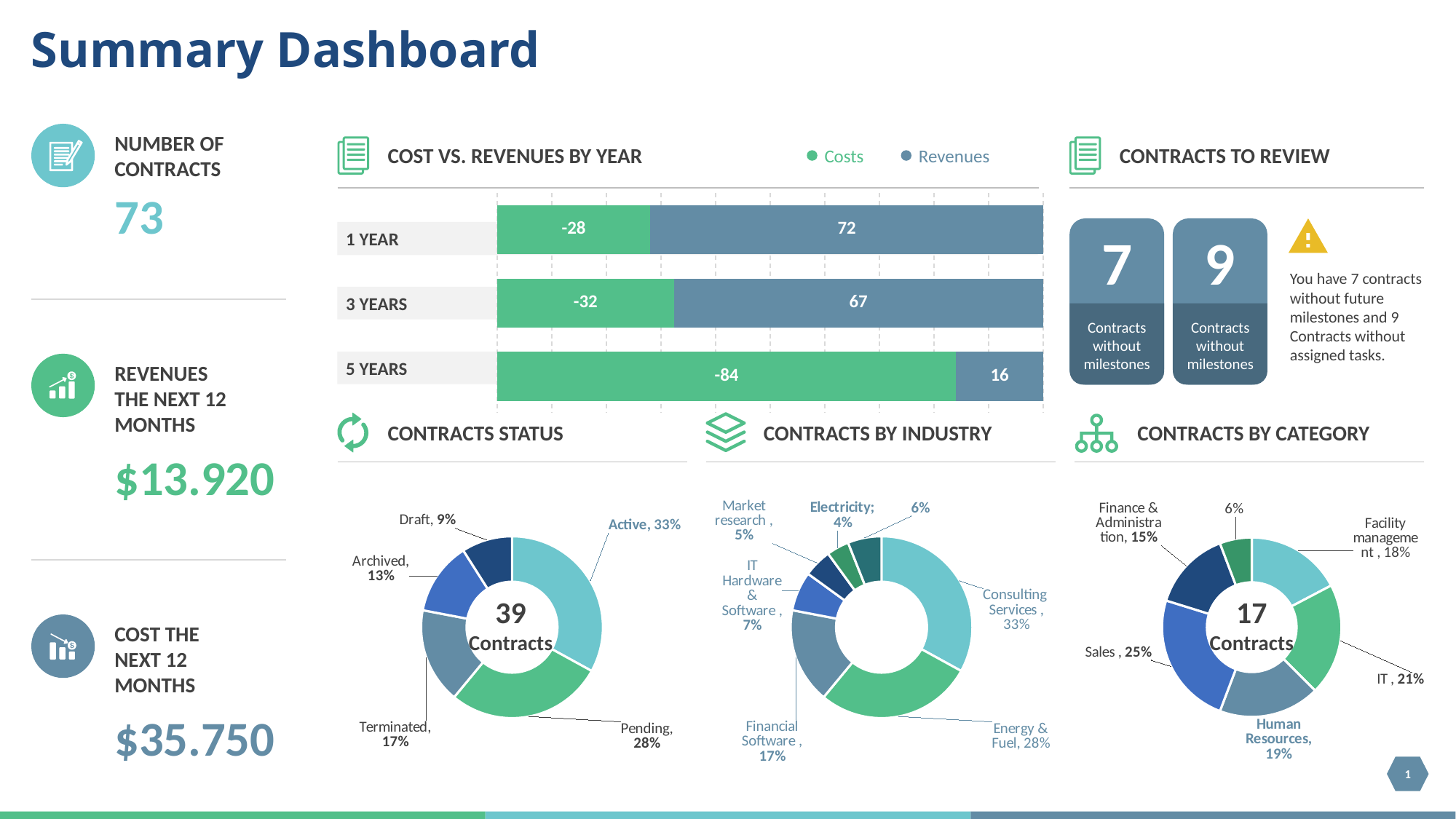
What kind of chart is the Cost vs. Revenues by Year chart? Bar chart In the Contracts by Industry chart, what is the share for Energy & Fuel? 28% In the Contracts Status chart, what share of contracts is Pending? 28% In the Cost vs. Revenues by Year chart, what is the Revenues value for 1 YEAR? 72 How many series does the legend of the Cost vs. Revenues by Year chart list? 2 In the Cost vs. Revenues by Year chart, what is the difference between the Revenues values for 1 YEAR and 3 YEARS? 5 In the Contracts by Category chart, what is the difference between the shares for Sales and Finance & Administration? 10% In the Cost vs. Revenues by Year chart, which year category has the lowest Revenues value? 5 YEARS In the Cost vs. Revenues by Year chart, what is the Costs value for 5 YEARS? -84 In the Contracts Status chart, which status has the smallest share? Draft In the Contracts by Industry chart, which industry has the largest share? Consulting Services In the Contracts by Category chart, which is larger: the share for Sales or the share for IT? Sales